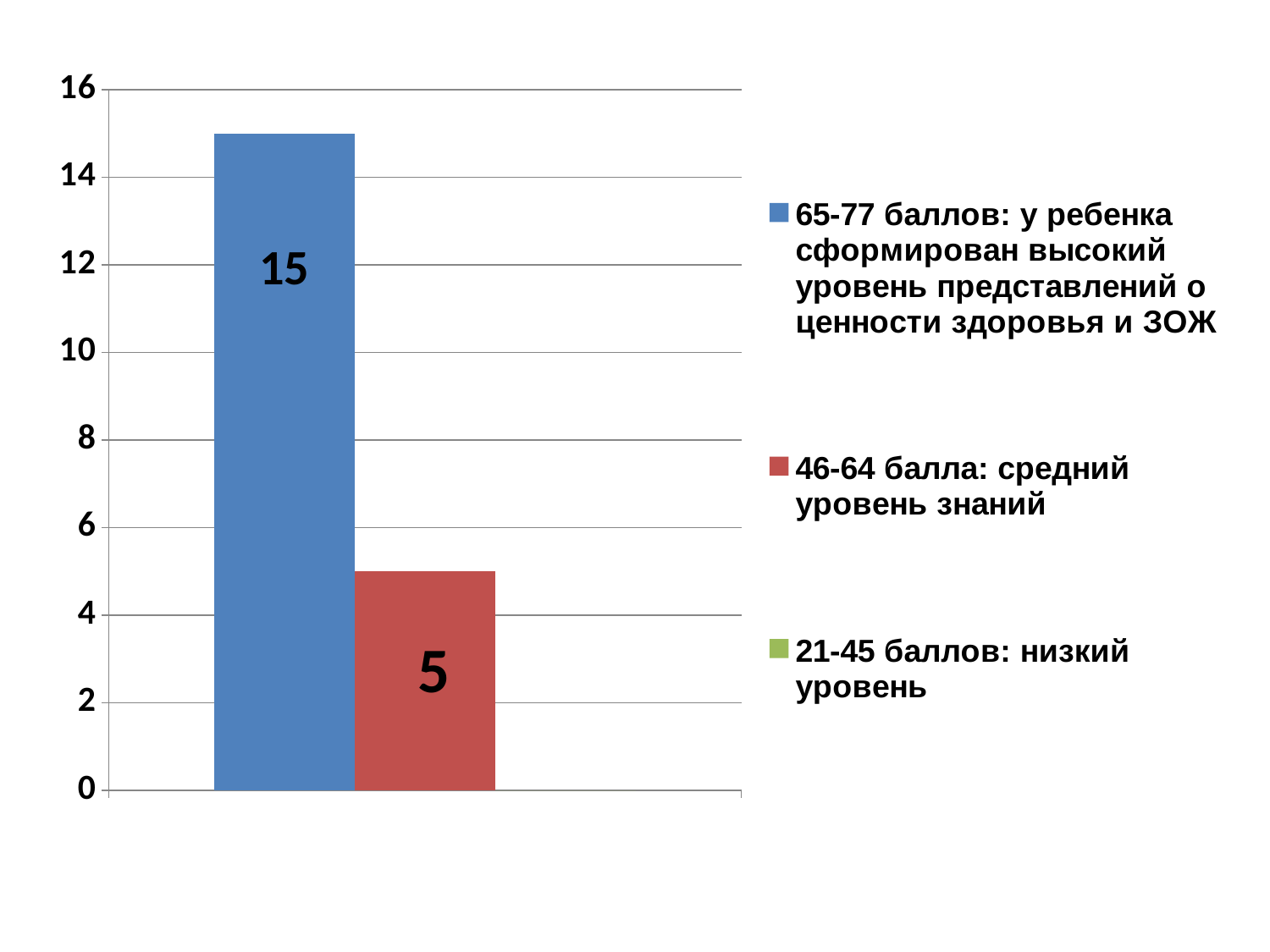
What is the value for the series "65-77 баллов: у ребенка сформирован высокий уровень представлений о ценности здоровья и ЗОЖ"? 15 Is the value for "46-64 балла: средний уровень знаний" greater or less than 10? less What is the maximum value shown on the vertical axis? 16 Is the value for "65-77 баллов" greater or less than 12? greater How many series does the legend list? 3 What colour is the bar for "46-64 балла: средний уровень знаний"? red What is the value for the series "46-64 балла: средний уровень знаний"? 5 What kind of chart is shown on the slide? bar chart What is the difference between the value for "65-77 баллов" and the value for "46-64 балла"? 10 How many bars are plotted on the chart? 2 Which is larger: the value for "65-77 баллов" or the value for "46-64 балла"? 65-77 баллов Which series has the highest value? 65-77 баллов: у ребенка сформирован высокий уровень представлений о ценности здоровья и ЗОЖ